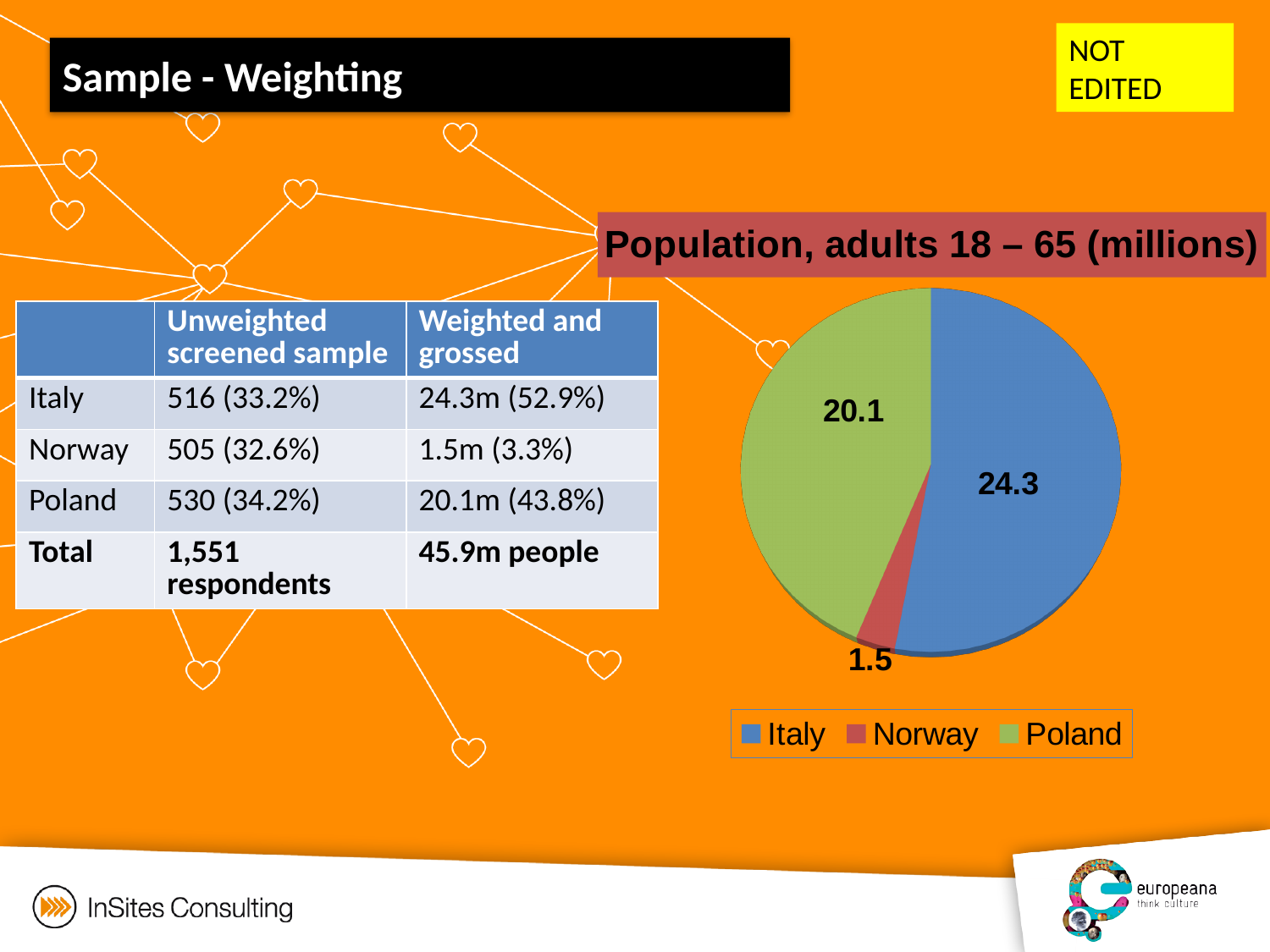
What is the value for Poland in the pie chart? 20.1 What is the value for Norway in the pie chart? 1.5 How many slices does the pie chart have? 3 Which is larger in the pie chart, the value for Italy or the value for Poland? Italy What is the difference between the values for Italy and Poland in the pie chart? 4.2 What is the value for Italy in the pie chart? 24.3 Which country has the largest slice in the pie chart? Italy What is the difference between the values for Poland and Norway in the pie chart? 18.6 What type of chart is shown on the slide? pie chart What is the total of all slices in the pie chart? 45.9 Which country has the smallest slice in the pie chart? Norway What is the title of the pie chart? Population, adults 18 – 65 (millions)